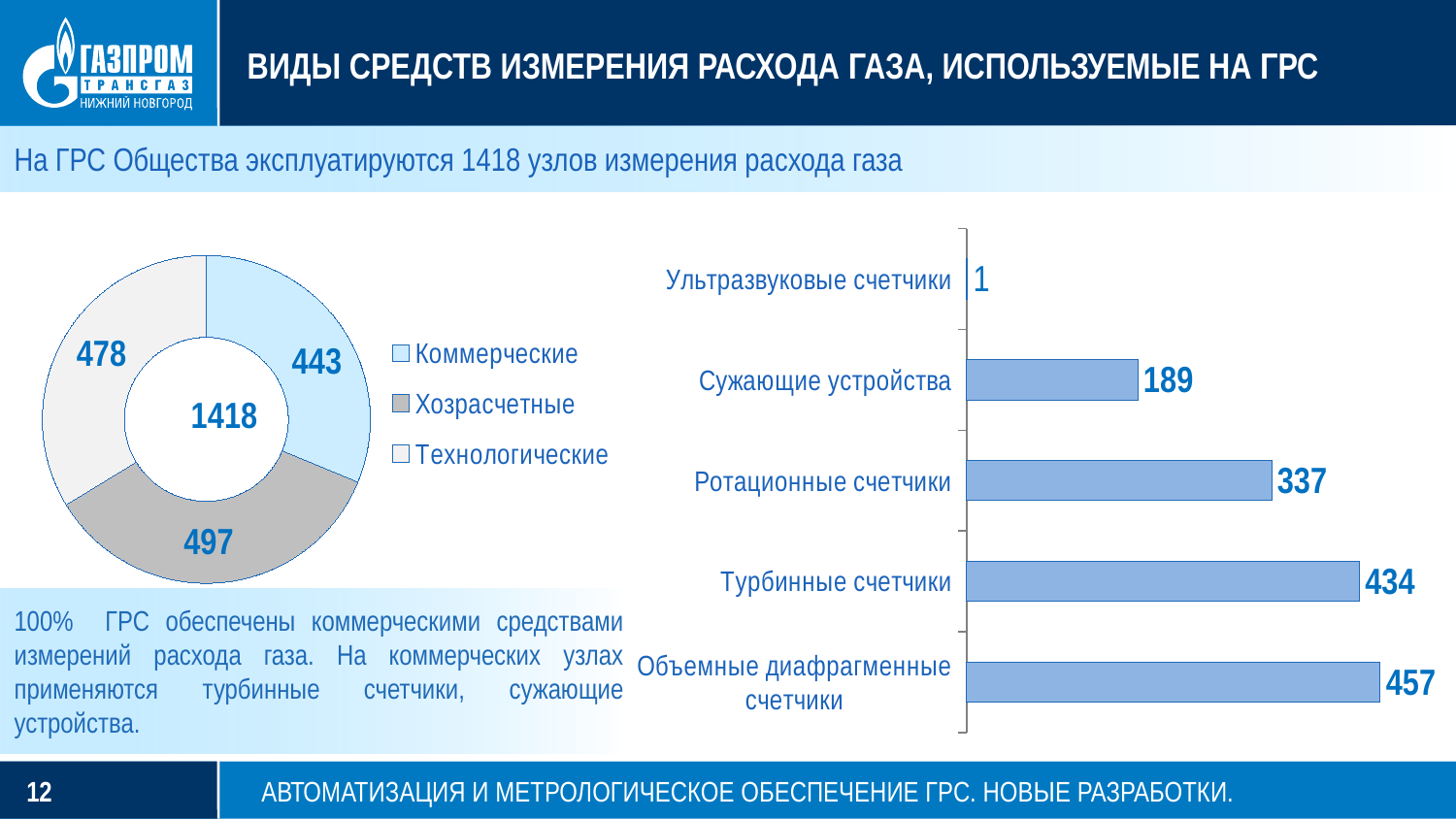
In the bar chart on the right, what is the value for Турбинные счетчики? 434 In the bar chart on the right, what is the difference between Объемные диафрагменные счетчики and Ротационные счетчики? 120 In the bar chart on the right, what is the value for Сужающие устройства? 189 In the doughnut chart on the left, what total is shown in the centre? 1418 In the bar chart on the right, which category has the highest value? Объемные диафрагменные счетчики In the bar chart on the right, which category has the lowest value? Ультразвуковые счетчики In the doughnut chart on the left, what is the value for Хозрасчетные? 497 What kind of chart is on the right side of the slide? Bar chart In the doughnut chart on the left, which category has the smallest value? Коммерческие In the bar chart on the right, how many categories are shown? 5 In the doughnut chart on the left, what is the difference between Хозрасчетные and Коммерческие? 54 How many entries does the legend of the doughnut chart on the left list? 3